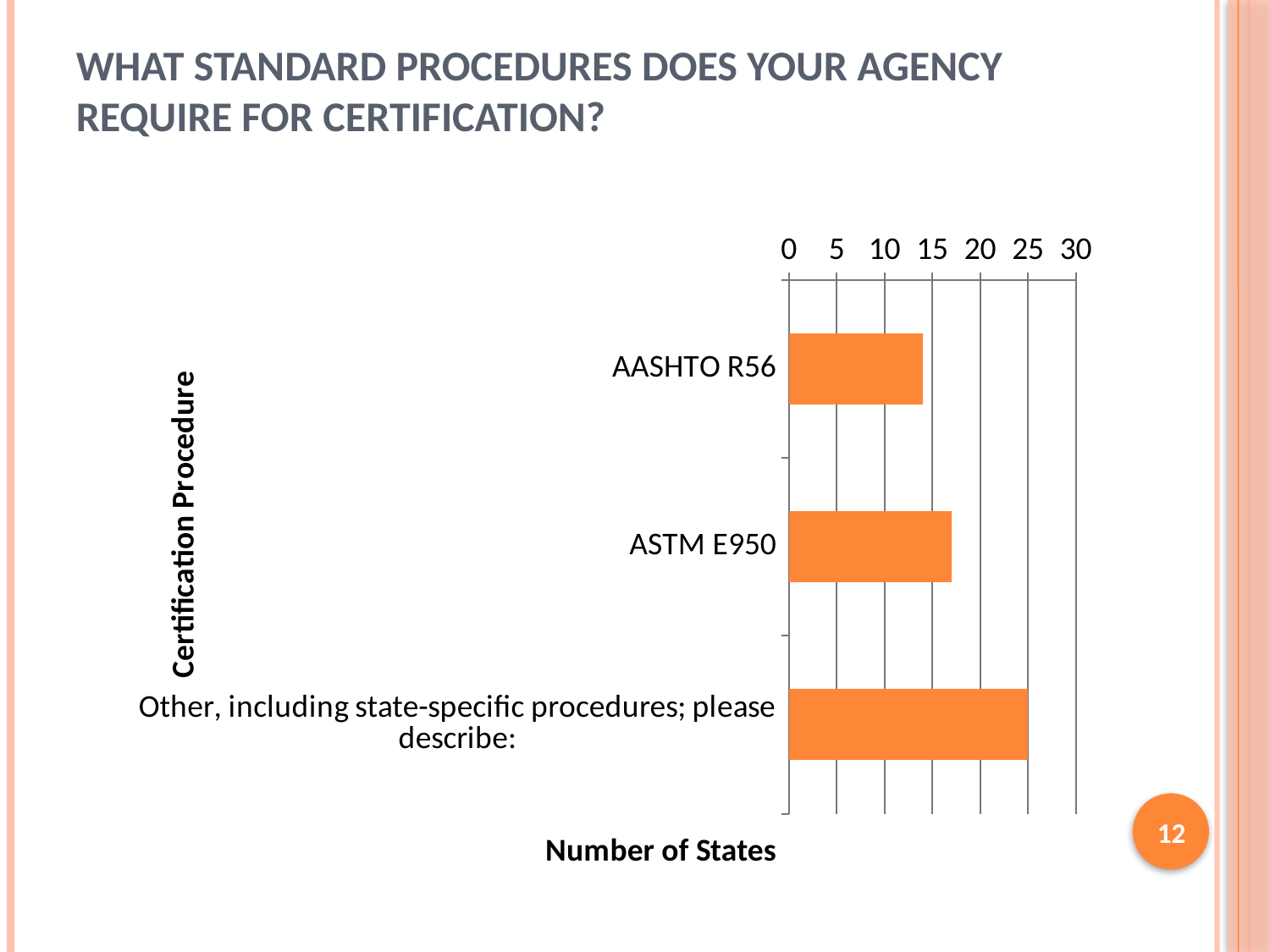
How many certification procedures are plotted in the chart? 3 Is the number of states for AASHTO R56 greater or less than 15? less Is the number of states for AASHTO R56 greater or less than 10? greater What is the title of the horizontal axis of the chart? Number of States What kind of chart is shown on the slide? bar chart Is the number of states for ASTM E950 greater or less than 15? greater Which certification procedure has the lowest number of states? AASHTO R56 What is the title of the vertical axis of the chart? Certification Procedure Which certification procedure has the highest number of states? Other, including state-specific procedures; please describe: Which has more states, ASTM E950 or AASHTO R56? ASTM E950 What is the number of states for "Other, including state-specific procedures; please describe:"? 25